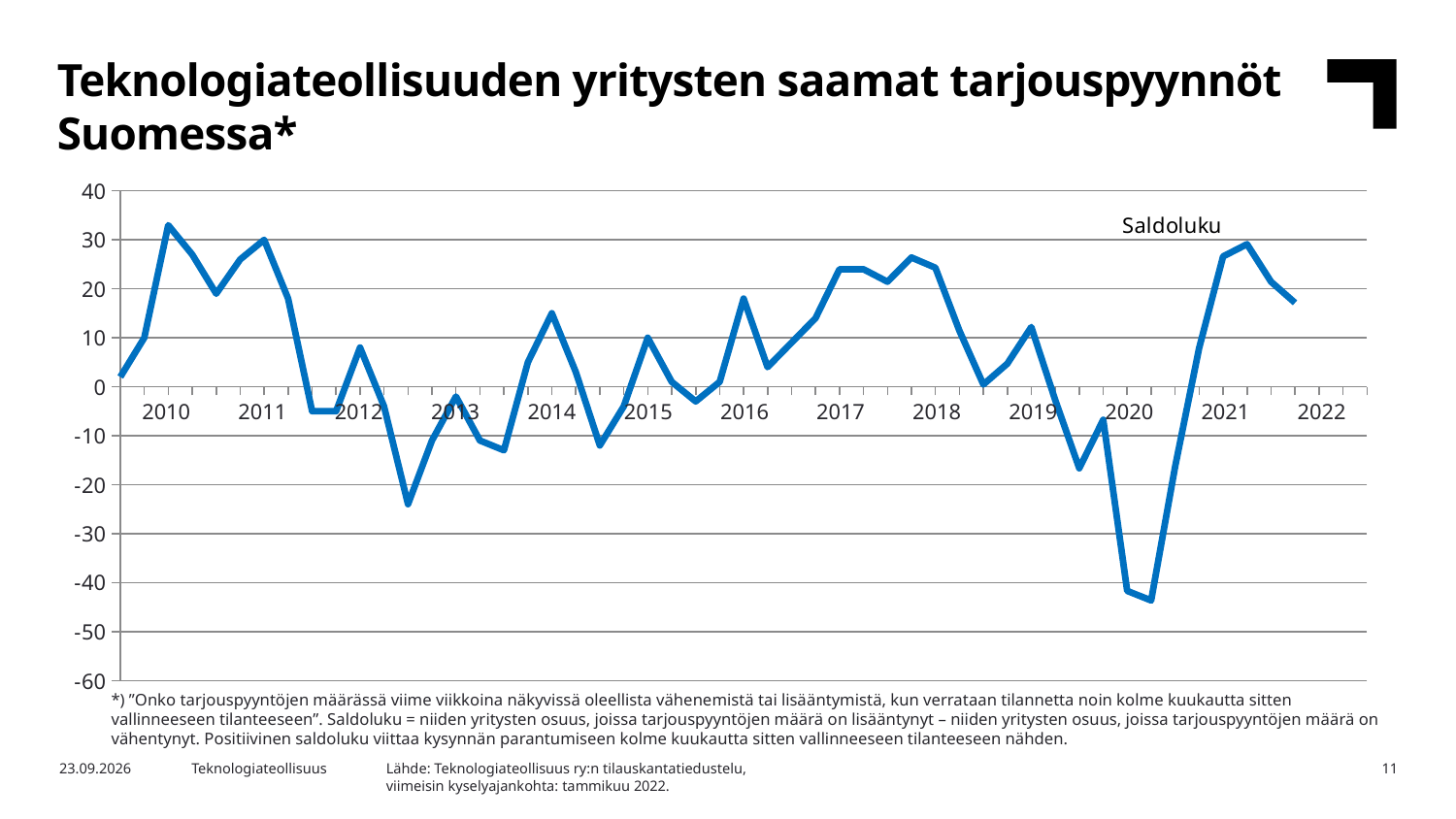
Which is lower: the lowest point of the line in 2012 or the lowest point in 2020? 2020 What kind of chart is shown on the slide? line chart What is the name of the series plotted in the chart? Saldoluku Does the line rise or fall from its 2021 peak to the last point in 2022? fall What are the minimum and maximum values shown on the y axis? -60 and 40 Is the lowest value of the line in 2012 greater or less than -20? less Is the highest value of the line in 2018 greater or less than 20? greater In which year does the line reach its lowest point? 2020 How many series does the chart plot? 1 How many year labels are shown on the x axis? 13 Is the last plotted value, in 2022, greater or less than 10? greater